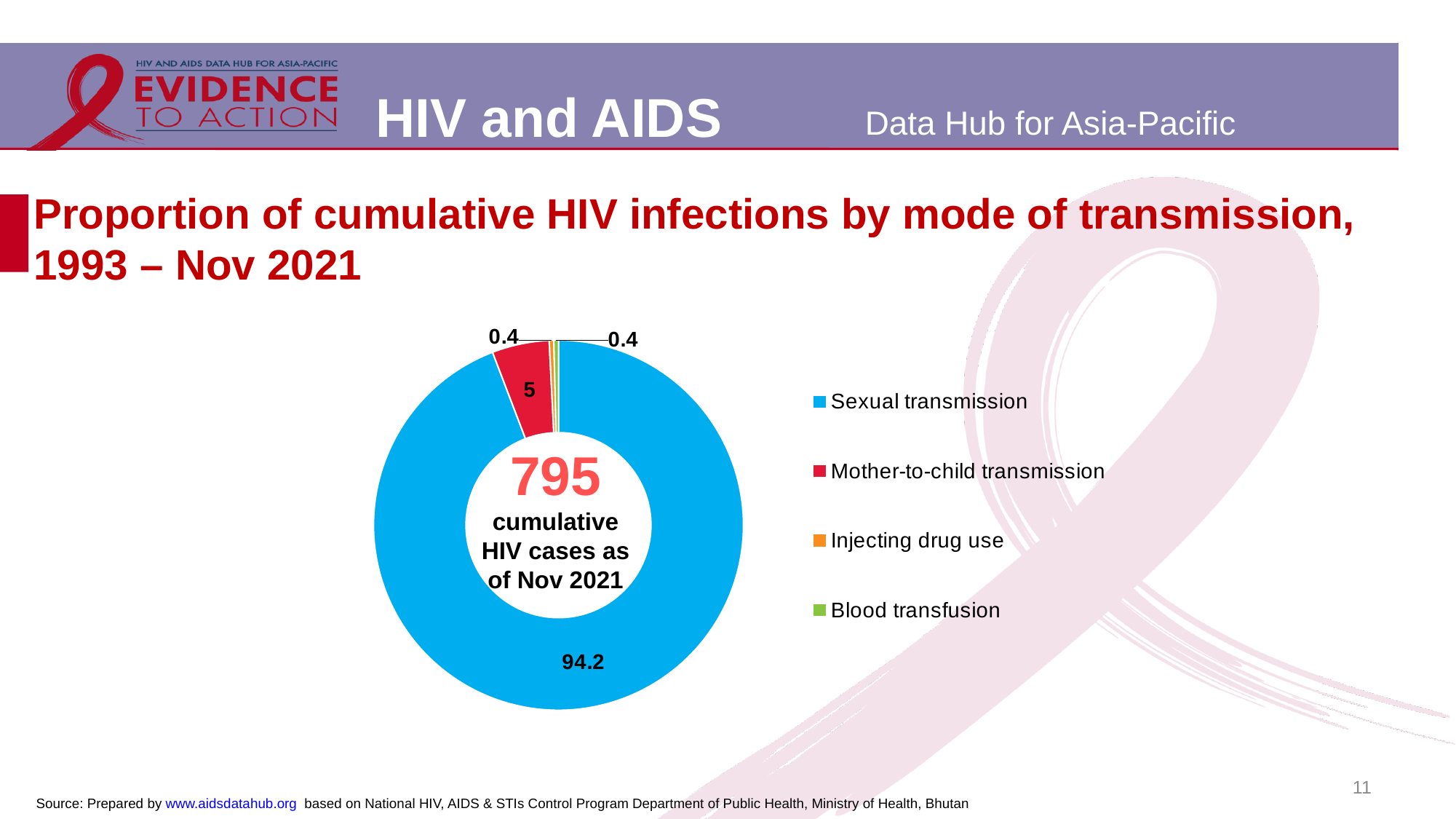
Which is larger, the proportion for mother-to-child transmission or for injecting drug use? Mother-to-child transmission What proportion of cumulative HIV infections is attributed to mother-to-child transmission? 5 Which colour represents mother-to-child transmission in the chart? Red What number of cumulative HIV cases as of Nov 2021 is shown in the centre of the chart? 795 How many modes of transmission does the legend list? 4 What kind of chart is shown on the slide? doughnut chart What proportion of cumulative HIV infections is attributed to sexual transmission? 94.2 Which mode of transmission accounts for the largest share of cumulative HIV infections? Sexual transmission What proportion of cumulative HIV infections is attributed to blood transfusion? 0.4 Do the proportions for injecting drug use and blood transfusion have the same value? Yes What proportion of cumulative HIV infections is attributed to injecting drug use? 0.4 What is the difference between the proportions for sexual transmission and mother-to-child transmission? 89.2